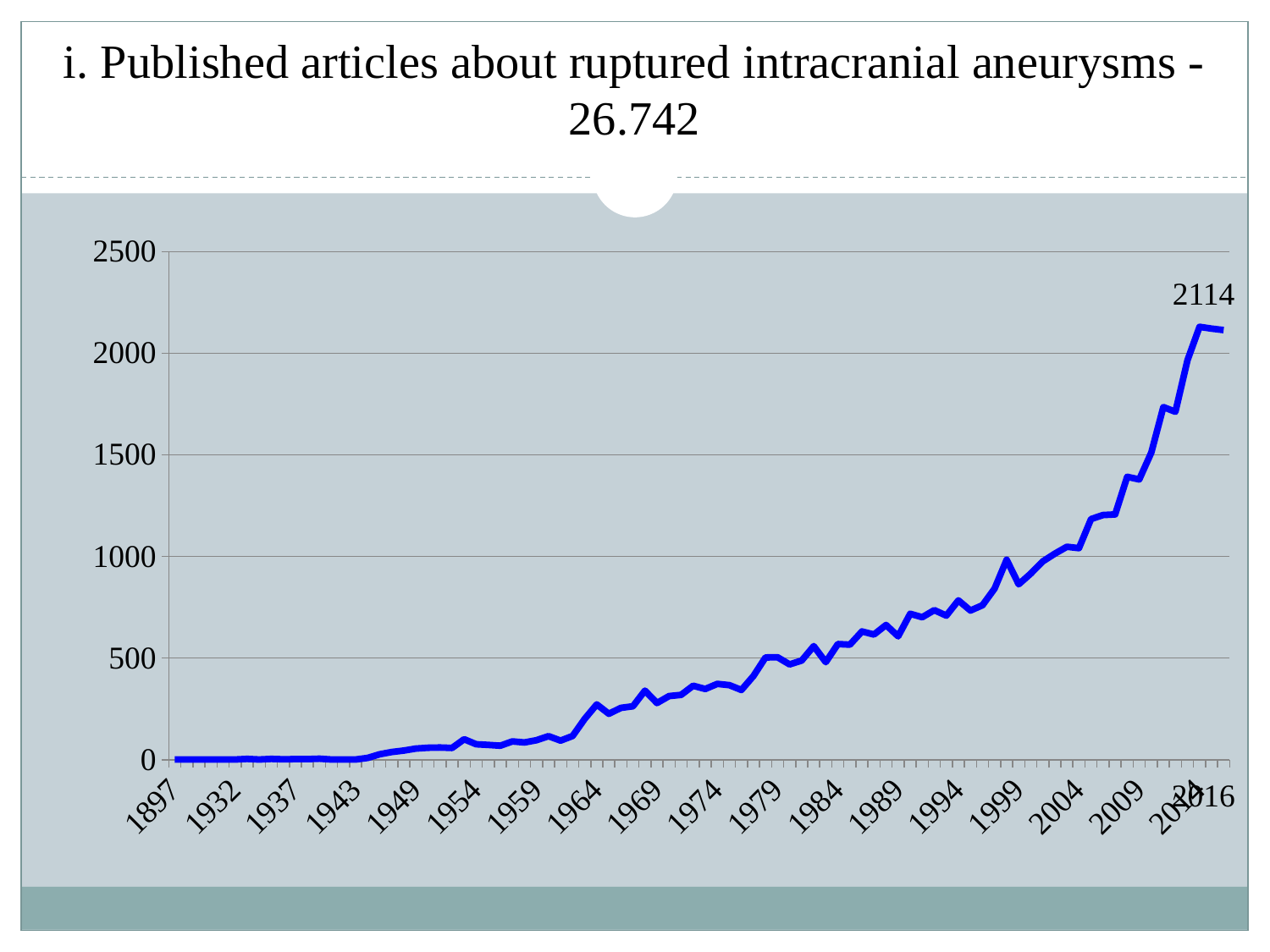
What kind of chart is shown on the slide? line chart Is the value for 1999 greater or less than 500? greater What is the highest value labelled on the line? 2114 Is the value for 1979 greater or less than 1000? less What colour is the plotted line? blue Do the values generally rise or fall from 1897 to 2016? rise Is the value for 1964 greater or less than 500? less What is the maximum value shown on the vertical axis? 2500 How many data series are plotted on the chart? 1